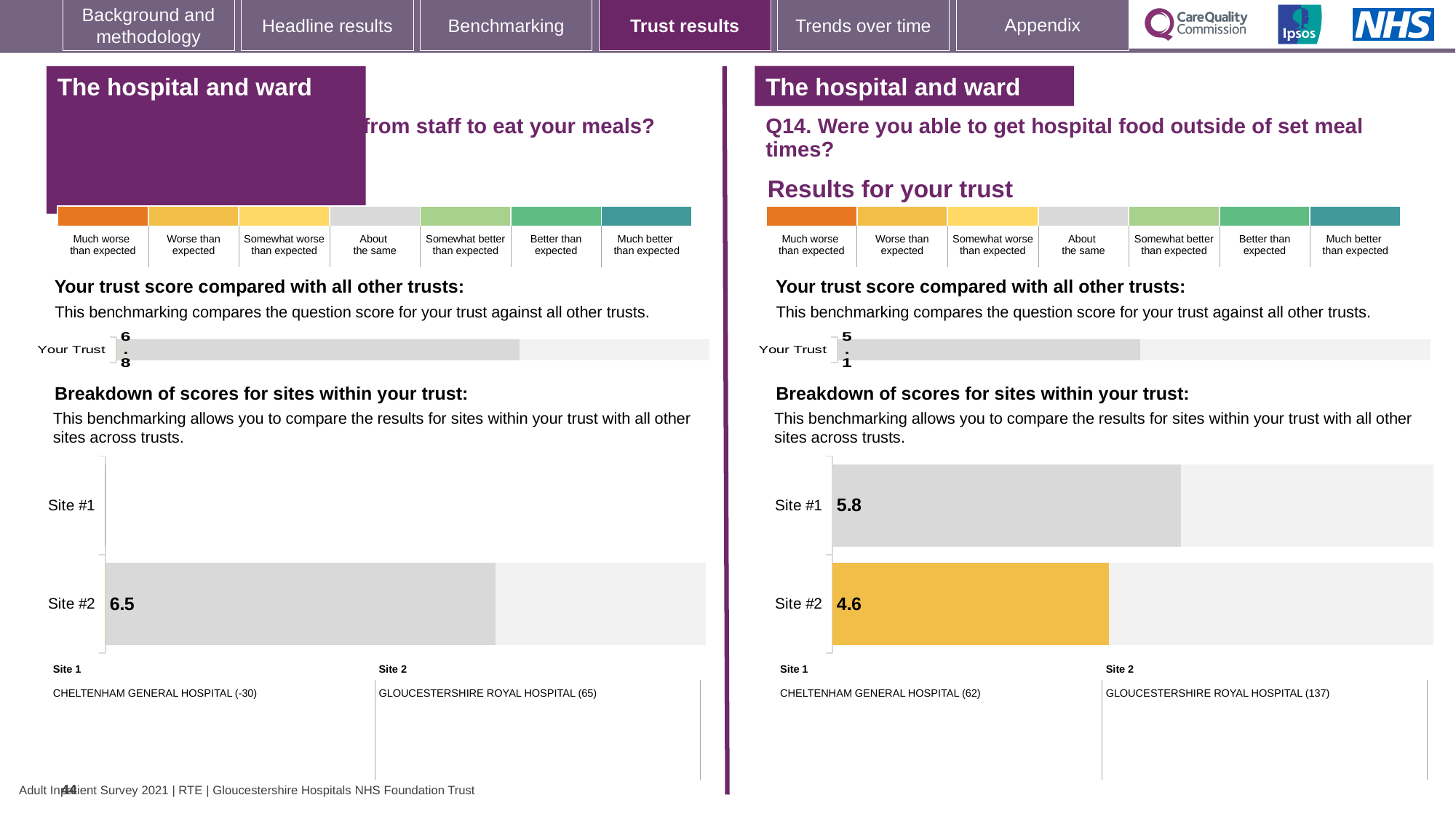
How many sites are shown in the site breakdown chart on the right-hand side for Q14? 2 On the right-hand chart for Q14, what is the site breakdown score for Site #2? 4.6 On the left-hand chart, what is the site breakdown score for Site #2? 6.5 On the right-hand chart for Q14, which hospital is Site 2? Gloucestershire Royal Hospital On the right-hand chart for Q14 (hospital food outside of set meal times), what is the site breakdown score for Site #1? 5.8 On the right-hand chart for Q14, what is the 'Your Trust' score compared with all other trusts? 5.1 On the right-hand chart for Q14, what is the difference between the Site #1 and Site #2 scores? 1.2 What type of chart is used for the breakdown of scores for sites within your trust? Bar chart On the right-hand chart for Q14, which site has the higher score, Site #1 or Site #2? Site #1 On the right-hand chart for Q14, what colour is the bar for Site #2? Yellow On the left-hand chart (question ending 'from staff to eat your meals?'), what is the 'Your Trust' score? 6.8 On the right-hand chart for Q14, which site has the lowest score? Site #2